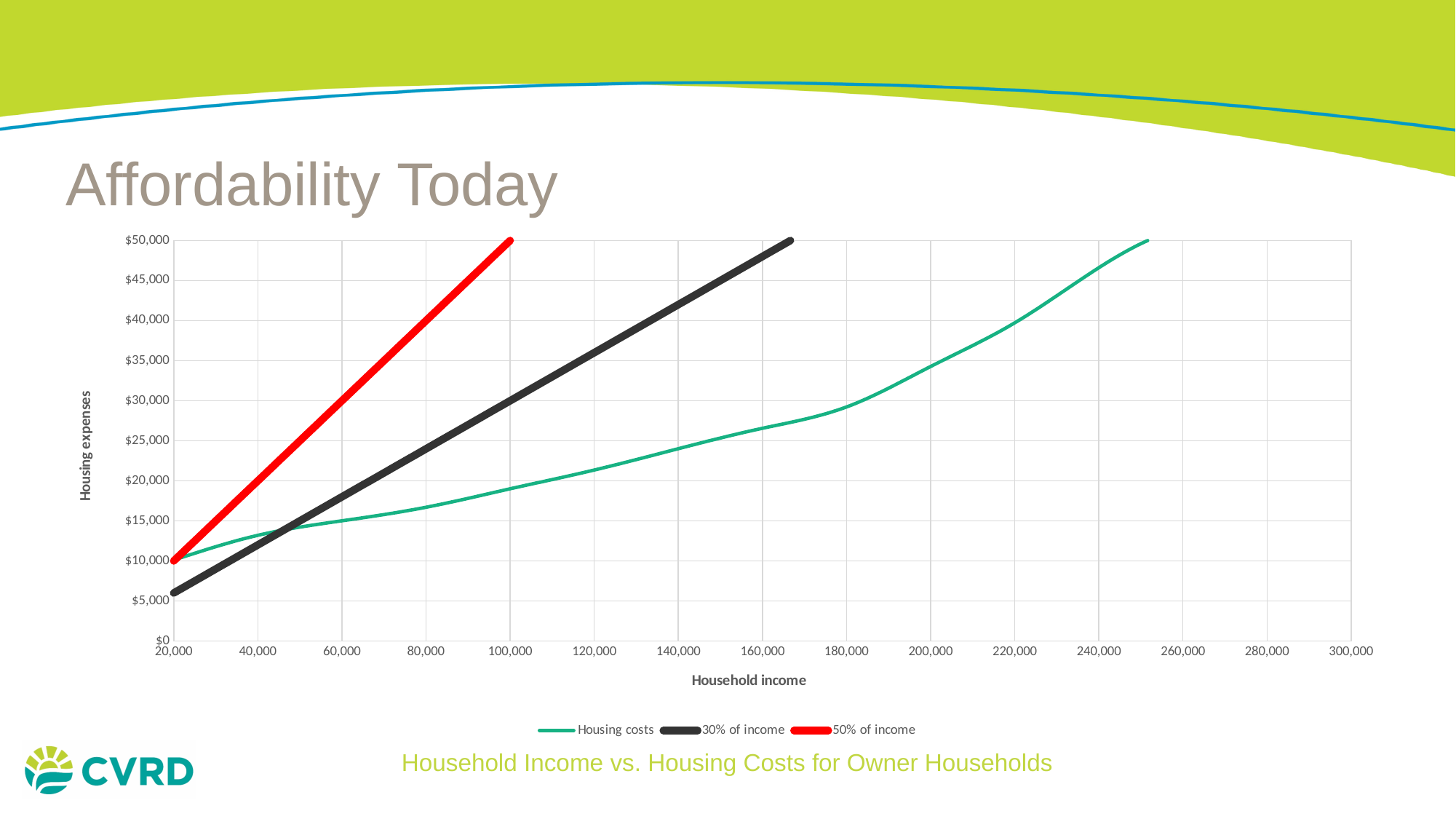
What is the title shown below the chart? Household Income vs. Housing Costs for Owner Households What is the label of the vertical axis? Housing expenses At a household income of 60,000, which is higher: Housing costs or 30% of income? 30% of income What is the value of the 50% of income line at a household income of 20,000? $10,000 At what household income does the 50% of income line reach $50,000? 100,000 Do the Housing costs values rise or fall as household income increases? rise Is the Housing costs value at a household income of 100,000 greater or less than $20,000? less How many series does the legend list? 3 Is the Housing costs value at a household income of 200,000 greater or less than $30,000? greater Is the 30% of income value at a household income of 140,000 greater or less than $40,000? greater What kind of chart is shown on the slide? line chart At a household income of 100,000, which is higher: Housing costs or 30% of income? 30% of income